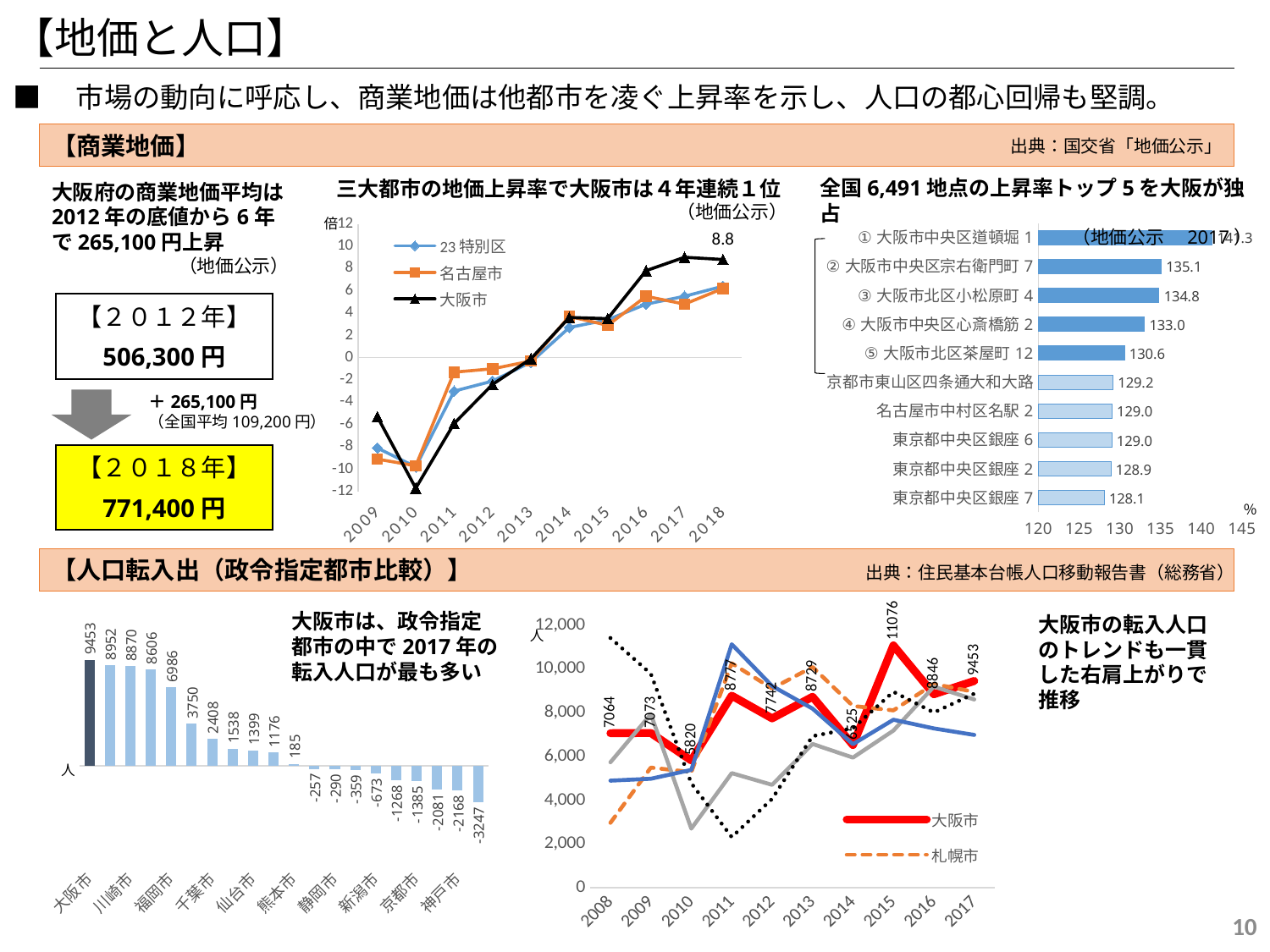
In the bar chart of 転入人口 by city at the bottom left, which city has the highest value? 大阪市 In the horizontal bar chart titled 「全国 6,491 地点の上昇率トップ 5 を大阪が独占」, what is the value for 大阪市北区茶屋町 12? 130.6 In the bar chart of 転入人口 by city at the bottom left, what is the value for 大阪市? 9453 In the chart titled 「三大都市の地価上昇率で大阪市は４年連続１位」, how many series does the legend list? 3 In the chart titled 「三大都市の地価上昇率で大阪市は４年連続１位」, which series has the lowest value in 2010? 大阪市 In the horizontal bar chart titled 「全国 6,491 地点の上昇率トップ 5 を大阪が独占」, what is the value for 大阪市中央区宗右衛門町 7? 135.1 In the horizontal bar chart titled 「全国 6,491 地点の上昇率トップ 5 を大阪が独占」, which location has the lowest value? 東京都中央区銀座 7 In the chart titled 「三大都市の地価上昇率で大阪市は４年連続１位」, is the value for 大阪市 in 2017 greater or less than 6? greater In the horizontal bar chart titled 「全国 6,491 地点の上昇率トップ 5 を大阪が独占」, how many locations are shown? 10 In the line chart at the bottom centre (2008–2017), what is the value for 大阪市 in 2015? 11076 In the horizontal bar chart titled 「全国 6,491 地点の上昇率トップ 5 を大阪が独占」, what is the difference between 大阪市北区小松原町 4 and 大阪市中央区心斎橋筋 2? 1.8 In the line chart at the bottom centre (2008–2017), what is the difference between the 大阪市 values for 2017 and 2016? 607